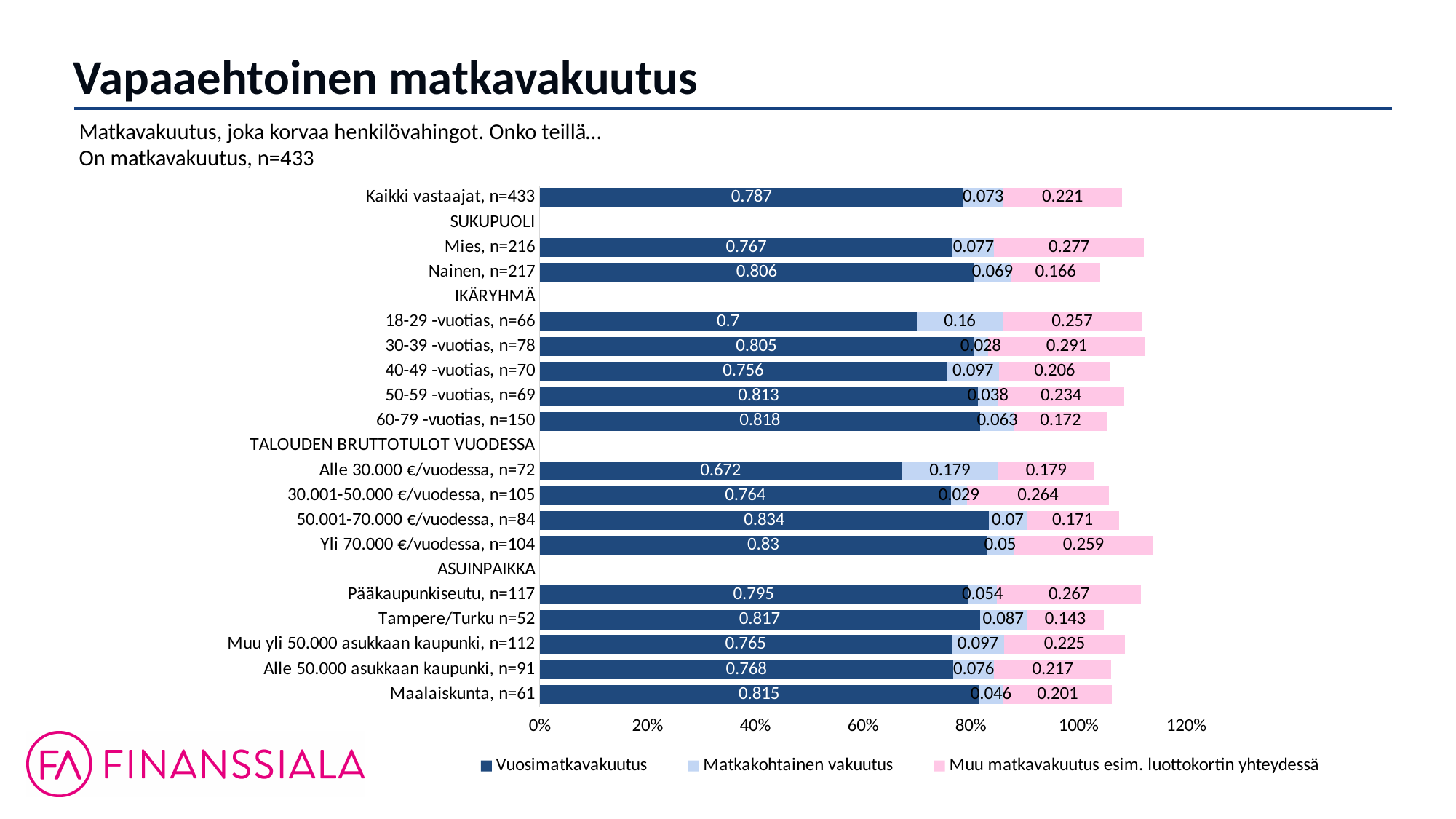
What is the Matkakohtainen vakuutus value for 18-29 -vuotias, n=66? 0.16 What is the Vuosimatkavakuutus value for Kaikki vastaajat, n=433? 0.787 What type of chart is shown on the slide? Stacked bar chart How many series does the legend list? 3 What is the difference between the Vuosimatkavakuutus values for Nainen, n=217 and Mies, n=216? 0.039 Which category has the lowest Vuosimatkavakuutus value? Alle 30.000 €/vuodessa, n=72 Which category has the lowest Matkakohtainen vakuutus value? 30-39 -vuotias, n=78 Which category has the highest Muu matkavakuutus esim. luottokortin yhteydessä value? 30-39 -vuotias, n=78 What is the total of the stacked bar for Kaikki vastaajat, n=433? 1.081 Which category has the highest Vuosimatkavakuutus value? 50.001-70.000 €/vuodessa, n=84 Which has a larger Vuosimatkavakuutus value, 60-79 -vuotias, n=150 or 40-49 -vuotias, n=70? 60-79 -vuotias, n=150 What is the Muu matkavakuutus esim. luottokortin yhteydessä value for Tampere/Turku n=52? 0.143